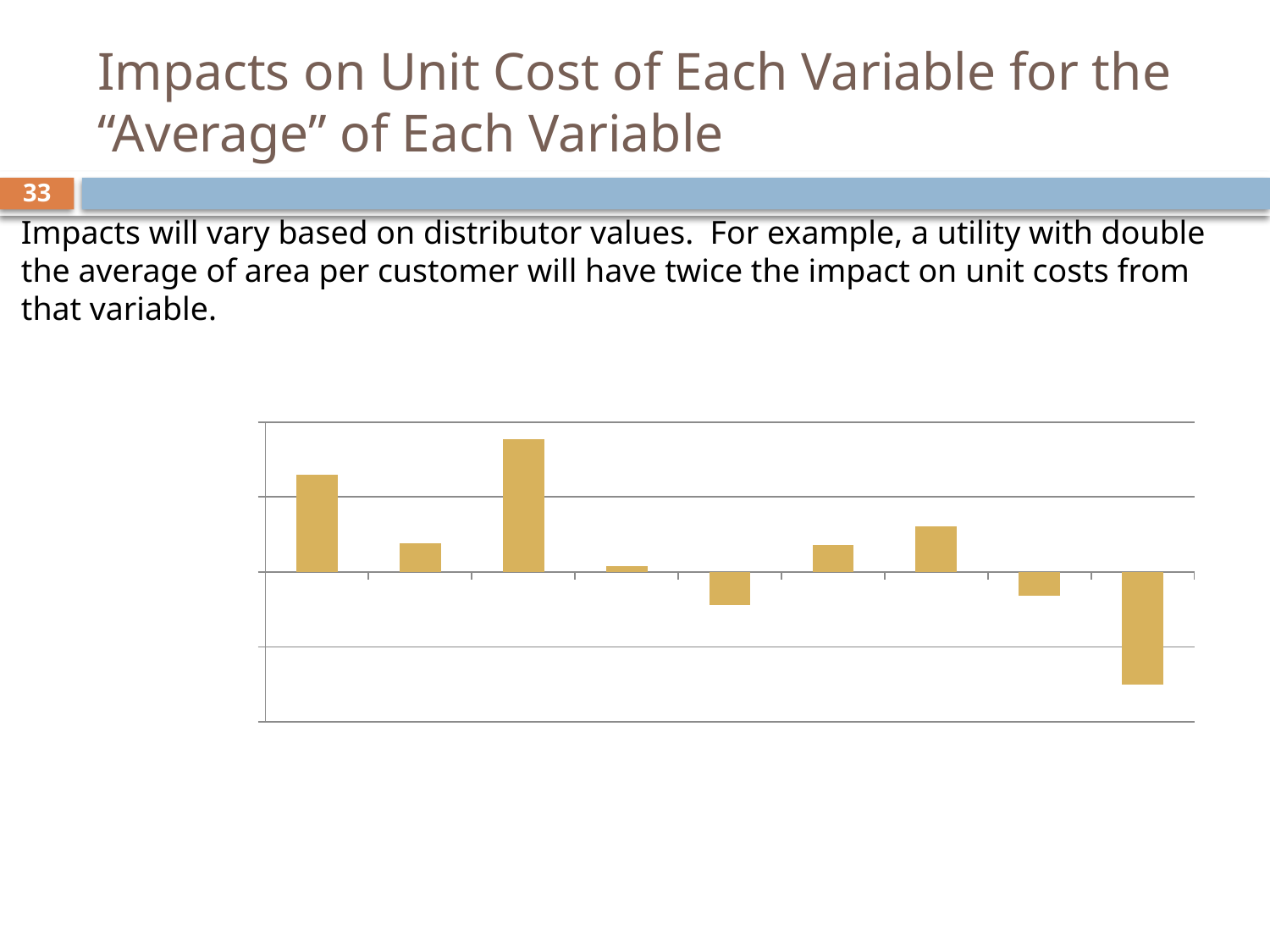
What kind of chart is shown on the slide? bar chart What colour are the bars in the chart? gold (tan) How many bars are plotted in the chart? 9 Counting from the left, which bar in the chart has the lowest (most negative) value? the ninth bar Which is larger, the first bar from the left or the second bar from the left? the first bar Is the fifth bar from the left positive or negative? negative How many bars in the chart extend above the zero line? 6 Counting from the left, which bar in the chart is the tallest (highest positive value)? the third bar How many bars in the chart extend below the zero line? 3 Which is larger, the seventh bar from the left or the sixth bar from the left? the seventh bar Does the chart display a legend? No